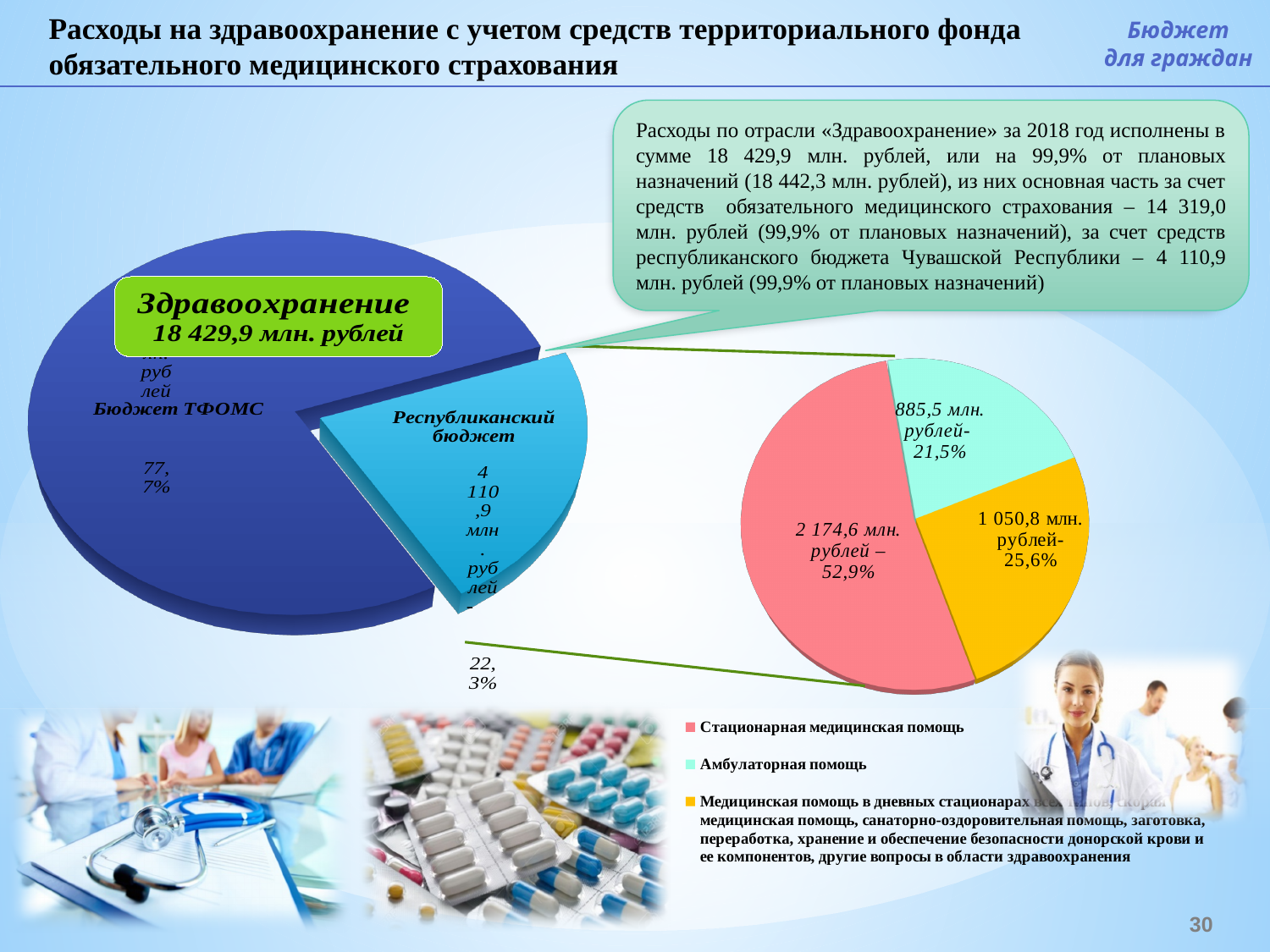
In the right pie chart, what colour is the Амбулаторная помощь slice? Light turquoise In the left pie chart, what share of the pie does Бюджет ТФОМС take? 77,7% In the left pie chart, what is the value for Республиканский бюджет? 4 110,9 млн. рублей In the right pie chart, what share of the pie does Амбулаторная помощь take? 21,5% In the right pie chart, how many slices are there? 3 In the right pie chart, what is the value for Стационарная медицинская помощь? 2 174,6 млн. рублей What kind of chart is the chart on the right of the slide? Pie chart In the right pie chart, which category has the largest slice? Стационарная медицинская помощь In the right pie chart, what is the value for the yellow slice (Медицинская помощь в дневных стационарах ...)? 1 050,8 млн. рублей In the right pie chart, which category has the smallest slice? Амбулаторная помощь In the left pie chart, which is larger: Бюджет ТФОМС or Республиканский бюджет? Бюджет ТФОМС In the right pie chart, what is the difference in percentage points between the Стационарная медицинская помощь share and the Амбулаторная помощь share? 31,4